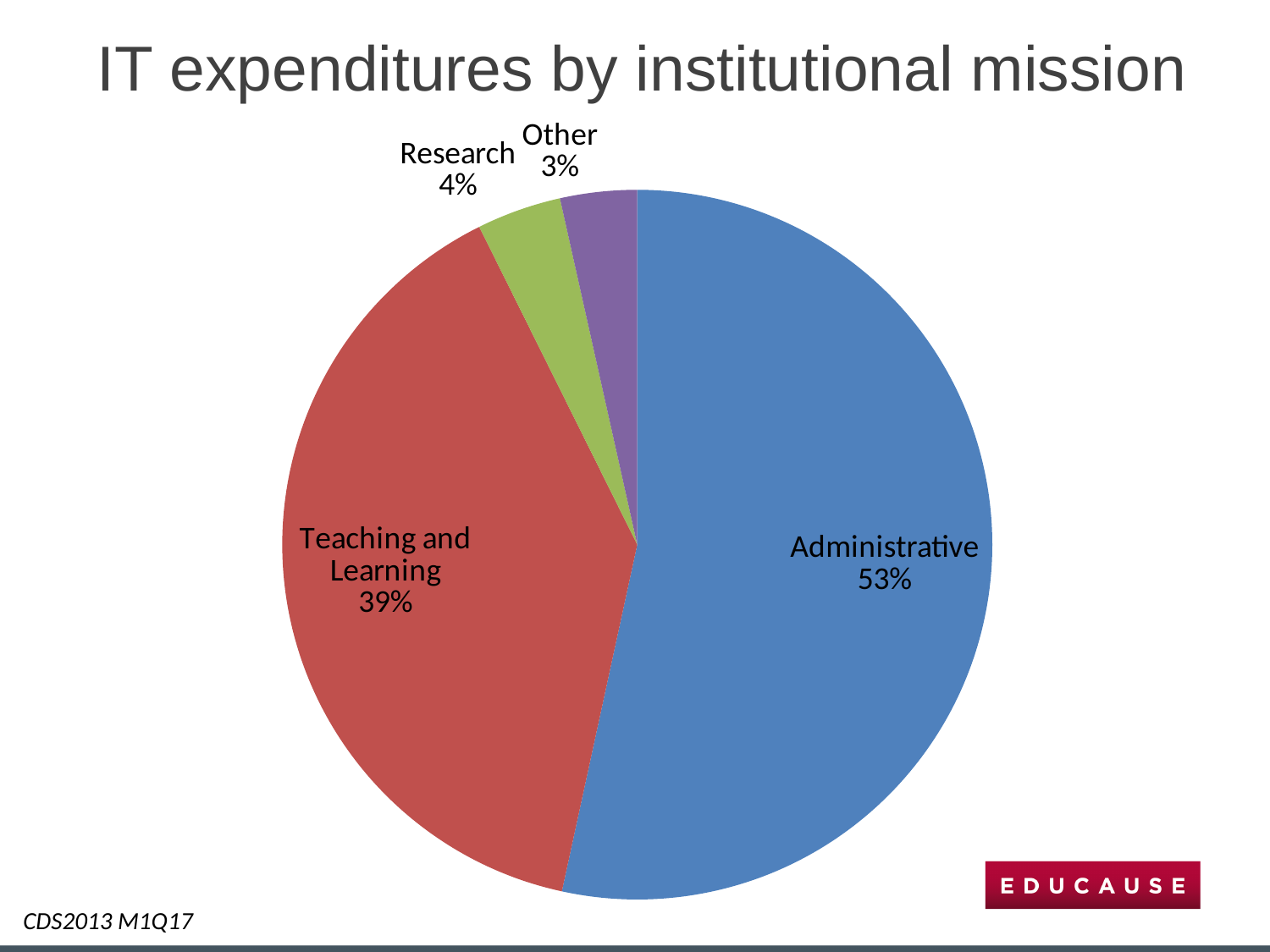
How many categories are shown in the pie chart? 4 What share of IT expenditures goes to Other? 3% Which category has the smallest share of IT expenditures? Other What share of IT expenditures goes to Teaching and Learning? 39% Which is larger, the share for Research or the share for Other? Research What colour is the Teaching and Learning slice? red What kind of chart is shown on the slide? pie chart What share of IT expenditures goes to Research? 4% Which category has the largest share of IT expenditures? Administrative What is the difference in percentage points between Administrative and Teaching and Learning? 14 What share of IT expenditures goes to Administrative? 53% What is the title of the chart? IT expenditures by institutional mission